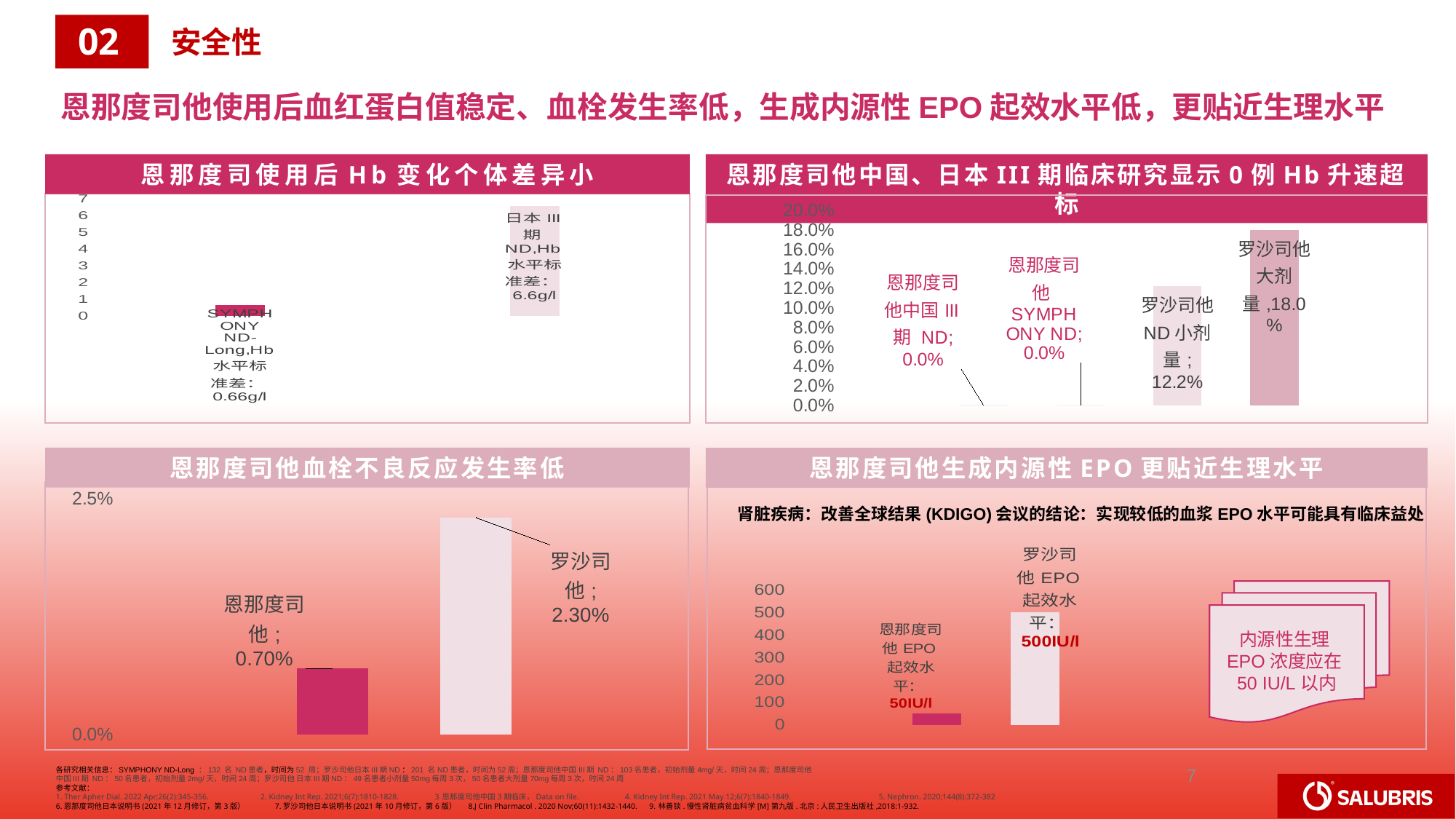
In the top-left chart (恩那度司使用后Hb变化个体差异小), which category has the higher Hb 水平标准差? 日本 III 期 ND In the top-left chart (恩那度司使用后Hb变化个体差异小), what is the Hb 水平标准差 for 日本 III 期 ND? 6.6g/l In the top-right chart (恩那度司他中国、日本III期临床研究显示0例Hb升速超标), how many categories are plotted? 4 In the top-right chart (恩那度司他中国、日本III期临床研究显示0例Hb升速超标), what is the value for 罗沙司他 ND 小剂量? 12.2% In the top-right chart (恩那度司他中国、日本III期临床研究显示0例Hb升速超标), what is the value for 罗沙司他大剂量? 18.0% In the top-right chart (恩那度司他中国、日本III期临床研究显示0例Hb升速超标), what is the difference between 罗沙司他大剂量 and 罗沙司他 ND 小剂量? 5.8% What type of chart is the bottom-left chart (恩那度司他血栓不良反应发生率低)? Bar chart In the bottom-left chart (恩那度司他血栓不良反应发生率低), what is the difference between 罗沙司他 and 恩那度司他? 1.60% In the top-left chart (恩那度司使用后Hb变化个体差异小), what is the Hb 水平标准差 for SYMPHONY ND-Long? 0.66g/l In the bottom-left chart (恩那度司他血栓不良反应发生率低), what is the value for 恩那度司他? 0.70% In the bottom-right chart (恩那度司他生成内源性EPO更贴近生理水平), which has the lower EPO 起效水平, 恩那度司他 or 罗沙司他? 恩那度司他 In the bottom-right chart (恩那度司他生成内源性EPO更贴近生理水平), what is the EPO 起效水平 for 罗沙司他? 500IU/l